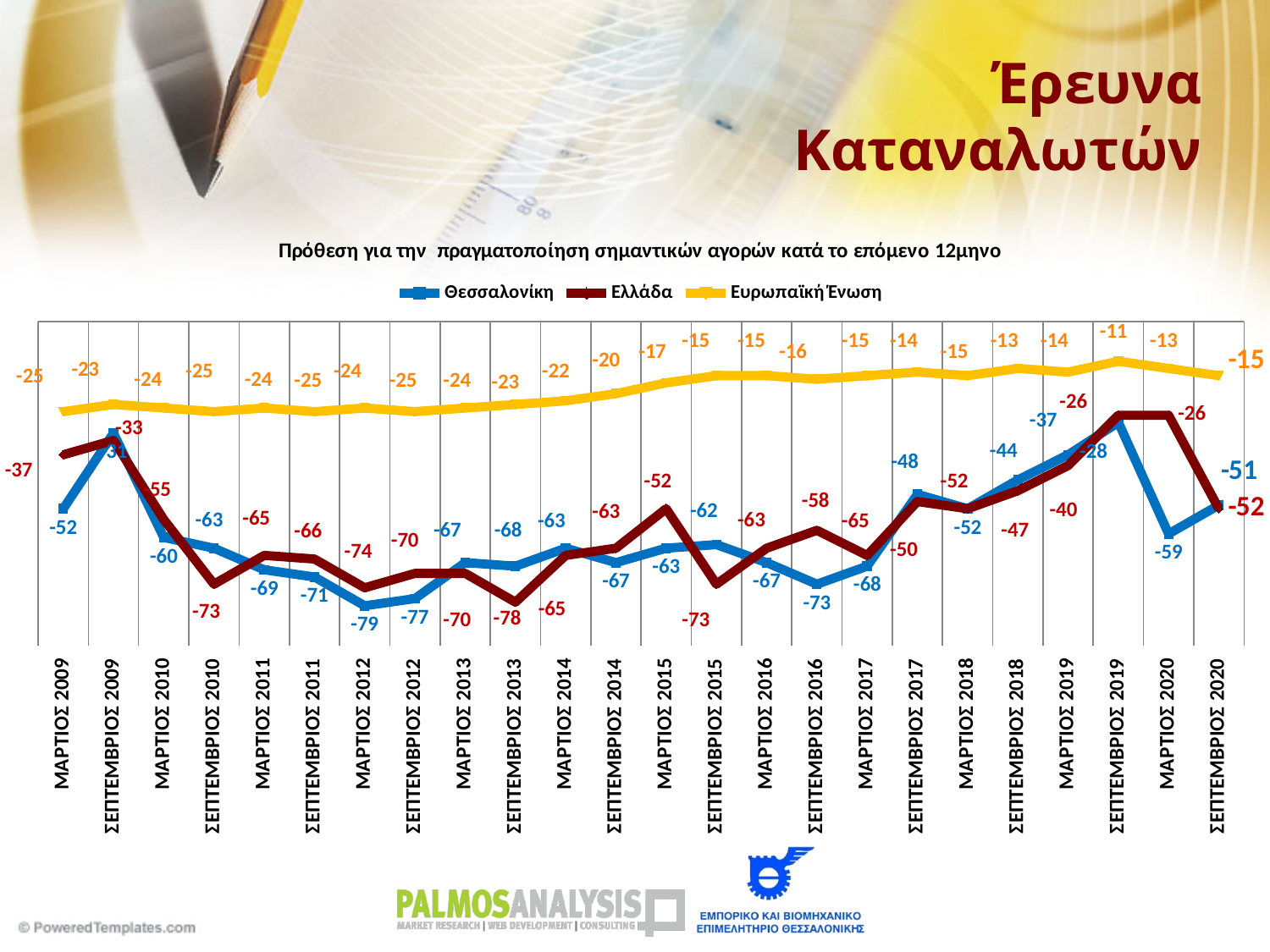
What colour is the line for Ευρωπαϊκή Ένωση? yellow What kind of chart is shown on the slide? line chart In ΜΑΡΤΙΟΣ 2009, which series has the higher value, Θεσσαλονίκη or Ελλάδα? Ελλάδα What is the value for Ελλάδα in ΣΕΠΤΕΜΒΡΙΟΣ 2020? -52 What is the value for Θεσσαλονίκη in ΜΑΡΤΙΟΣ 2012? -79 How many series does the legend list? 3 What is the difference between the Ελλάδα and Θεσσαλονίκη values in ΜΑΡΤΙΟΣ 2020? 33 In which period does the Ευρωπαϊκή Ένωση series reach its highest value? ΣΕΠΤΕΜΒΡΙΟΣ 2019 In which period does the Θεσσαλονίκη series reach its lowest value? ΜΑΡΤΙΟΣ 2012 What is the value for Ελλάδα in ΣΕΠΤΕΜΒΡΙΟΣ 2013? -78 How many time points are plotted along the x axis? 24 What is the value for Ευρωπαϊκή Ένωση in ΣΕΠΤΕΜΒΡΙΟΣ 2019? -11